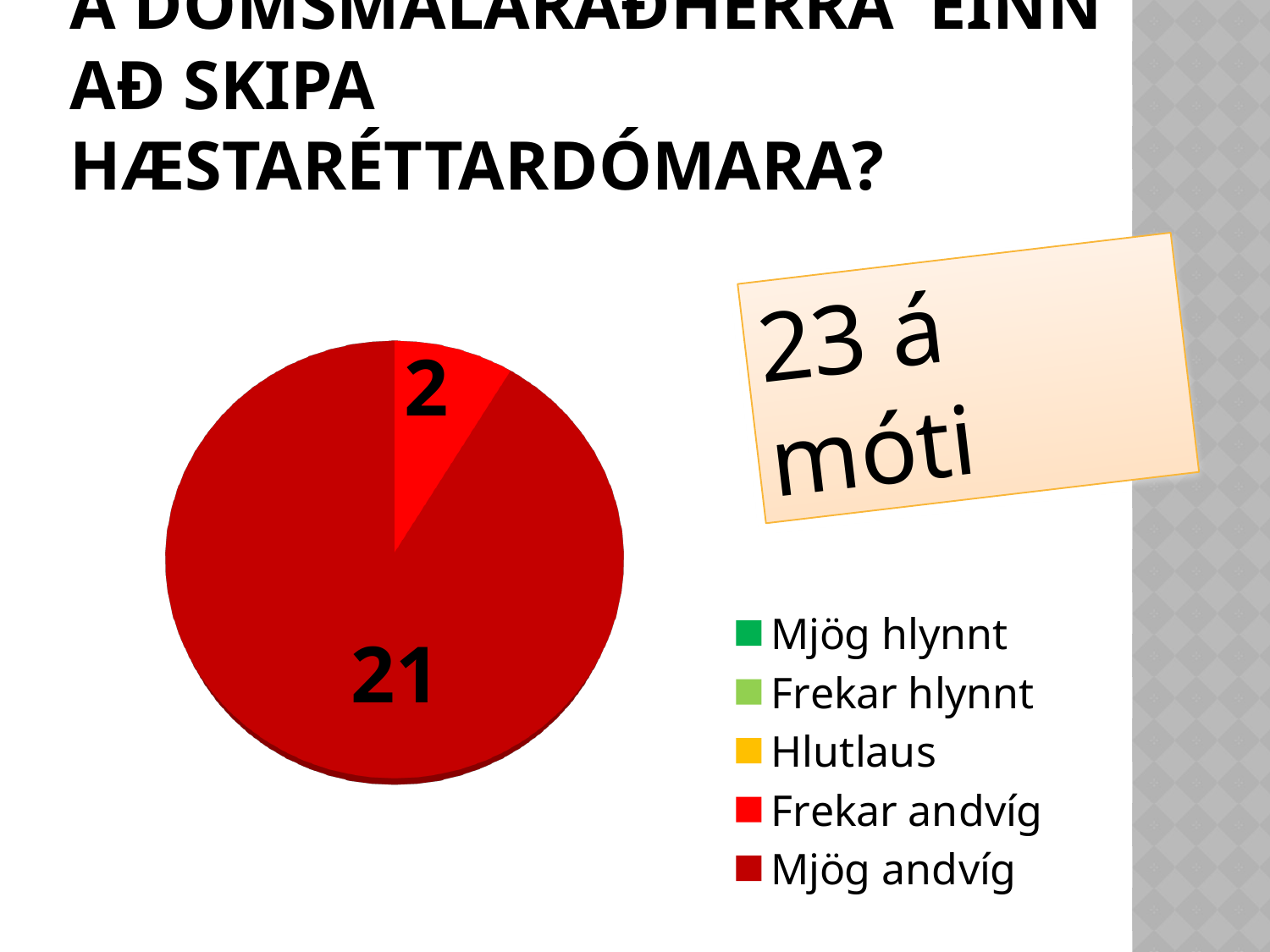
How many entries does the chart legend list? 5 What does the text box next to the pie chart say? 23 á móti What is the difference between the Mjög andvíg value and the Frekar andvíg value? 19 What value is shown for the Mjög andvíg slice of the pie chart? 21 What colour represents Mjög andvíg in the legend? Dark red What value is shown for the Frekar andvíg slice of the pie chart? 2 What kind of chart is shown on the slide? Pie chart Which category has the largest slice in the pie chart? Mjög andvíg Which is larger, the Mjög andvíg slice or the Frekar andvíg slice? Mjög andvíg What is the total of the two labelled slices in the pie chart? 23 How many slices with data labels are visible in the pie chart? 2 Of the two labelled slices, which category has the smaller value? Frekar andvíg